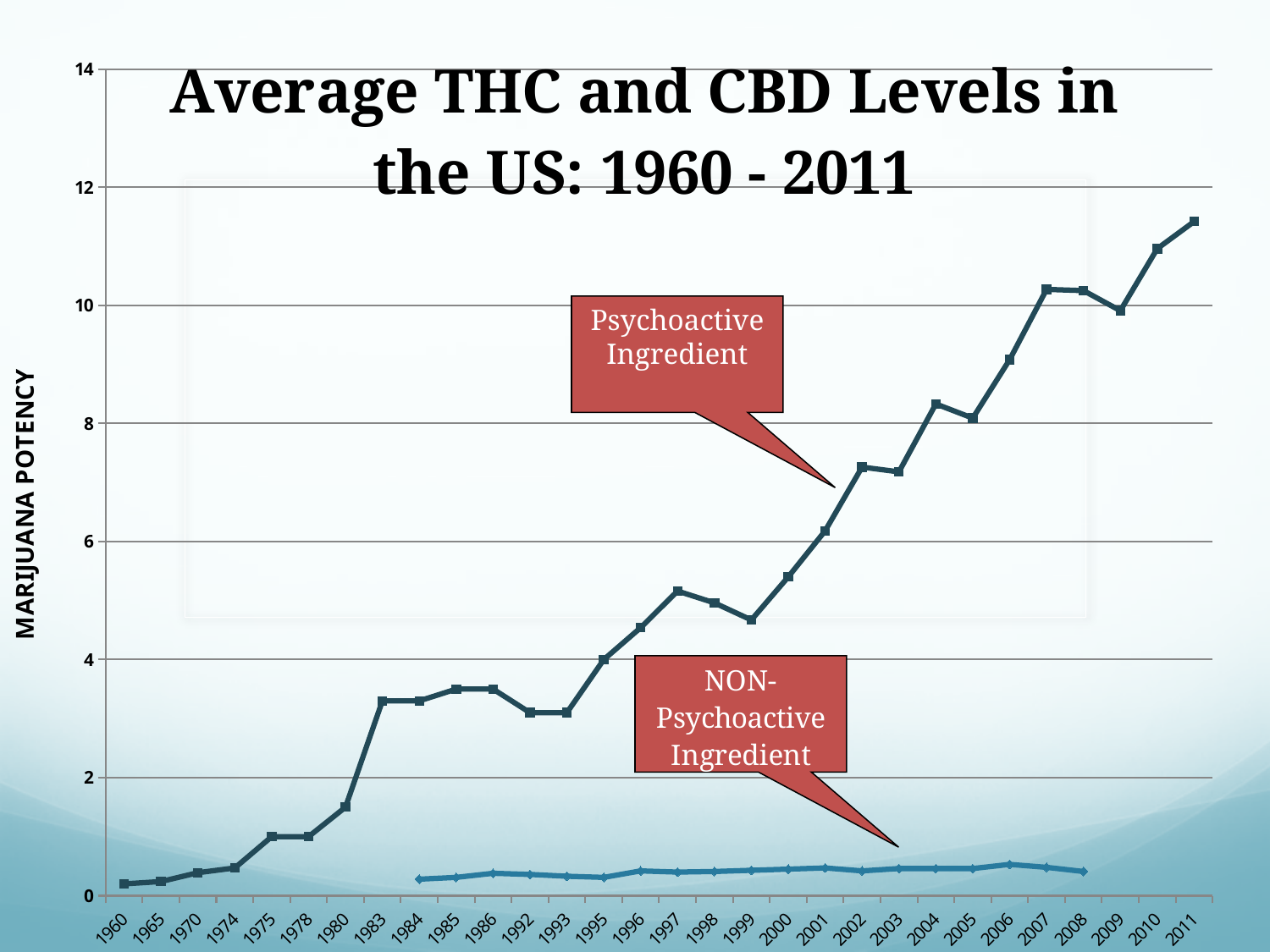
What is the label on the vertical axis? MARIJUANA POTENCY Is the Psychoactive Ingredient value for 2011 greater or less than 10? greater Which is larger, the Psychoactive Ingredient value in 2011 or in 1960? 2011 Does the Psychoactive Ingredient line generally rise or fall from 1960 to 2011? rise What kind of chart is shown on the slide? line chart In which year is the Psychoactive Ingredient line at its lowest value? 1960 Is the NON-Psychoactive Ingredient value for 2000 greater or less than 2? less Is the Psychoactive Ingredient value for 1999 greater or less than 4? greater How many years are labelled along the x axis? 30 What is the title of the chart? Average THC and CBD Levels in the US: 1960 - 2011 In which year does the Psychoactive Ingredient line reach its highest value? 2011